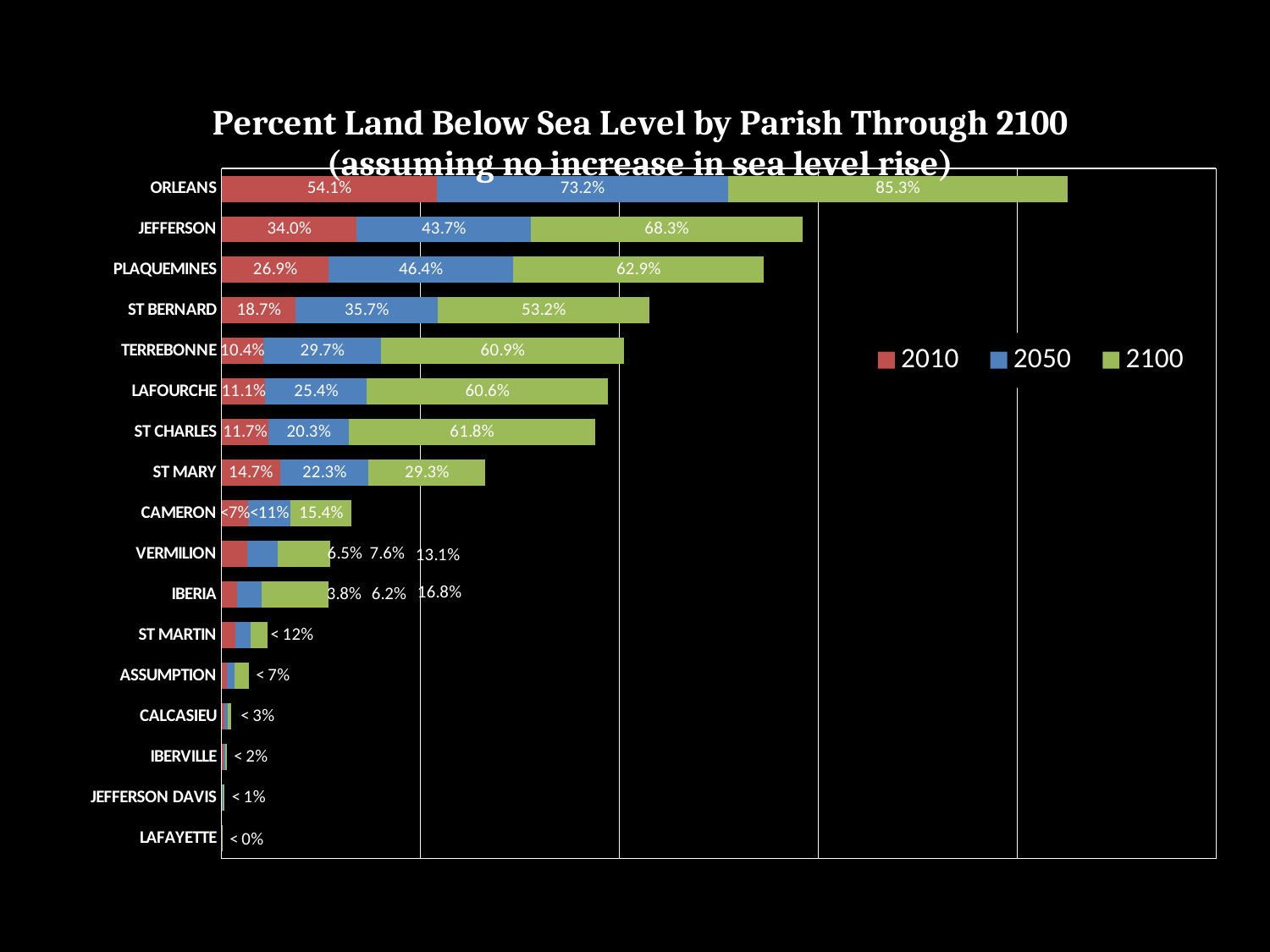
How many parishes are shown on the chart? 17 What is the difference between the 2100 and 2010 values for Orleans? 31.2 percentage points Which is larger, the 2050 value for St Bernard or the 2050 value for Terrebonne? St Bernard What is the 2050 value for Plaquemines? 46.4% Which parish has the highest 2100 value? Orleans What is the 2100 value for St Bernard? 53.2% What is the 2050 value for Terrebonne? 29.7% What is the 2100 value for Orleans? 85.3% What kind of chart is this? Stacked bar chart What is the 2010 value for Jefferson? 34.0% How many series does the legend list? 3 What are the three series listed in the legend? 2010, 2050, 2100